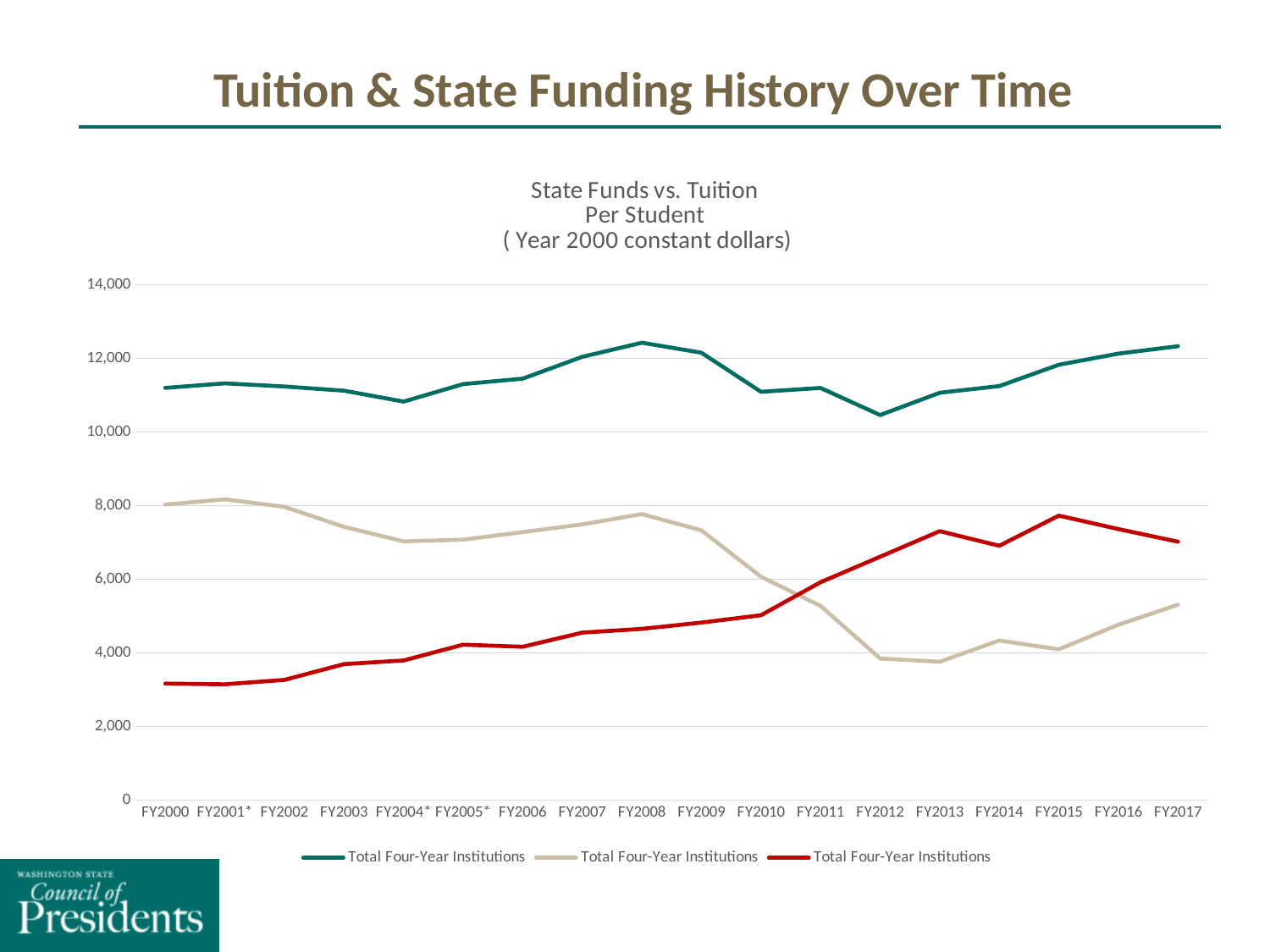
Does the red line generally rise or fall from FY2000 to FY2017? Rise How many series does the legend list? 3 Is the value of the red line at FY2000 greater or less than 4,000? less What is the title of the chart? State Funds vs. Tuition Per Student ( Year 2000 constant dollars) In which fiscal year does the dark green line reach its highest point? FY2008 In which fiscal year does the red line reach its highest point? FY2015 What kind of chart is shown on the slide? Line chart Is the value of the dark green line at FY2000 greater or less than 10,000? greater In which fiscal year does the dark green line reach its lowest point? FY2012 At FY2017, which line is higher, the red line or the tan line? The red line Is the value of the red line at FY2017 greater or less than 6,000? greater How many fiscal years are plotted along the x axis? 18